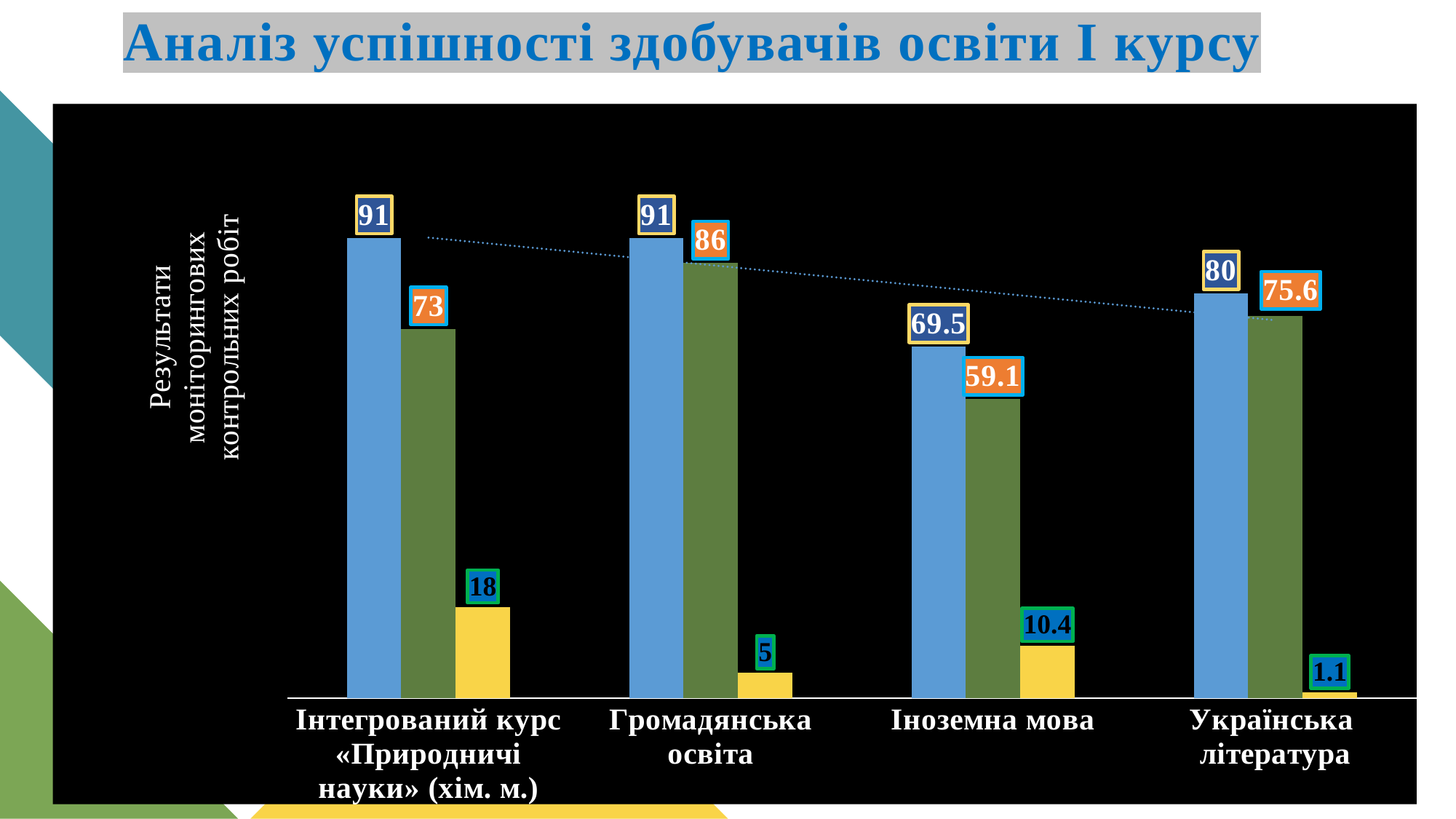
Which category has the highest green bar? Громадянська освіта What is the value of the blue bar for Громадянська освіта? 91 Which is larger: the green bar for Українська література or the green bar for Інтегрований курс «Природничі науки» (хім. м.)? Українська література How many categories are shown on the x axis? 4 What type of chart is shown on the slide? Bar chart What is the value of the yellow bar for Українська література? 1.1 What is the value of the green bar for Іноземна мова? 59.1 What is the value of the green bar for Інтегрований курс «Природничі науки» (хім. м.)? 73 What is the difference between the yellow bars for Інтегрований курс «Природничі науки» (хім. м.) and Громадянська освіта? 13 What is the difference between the blue bar and the green bar for Іноземна мова? 10.4 Which category has the lowest blue bar? Іноземна мова Which category has the highest yellow bar? Інтегрований курс «Природничі науки» (хім. м.)